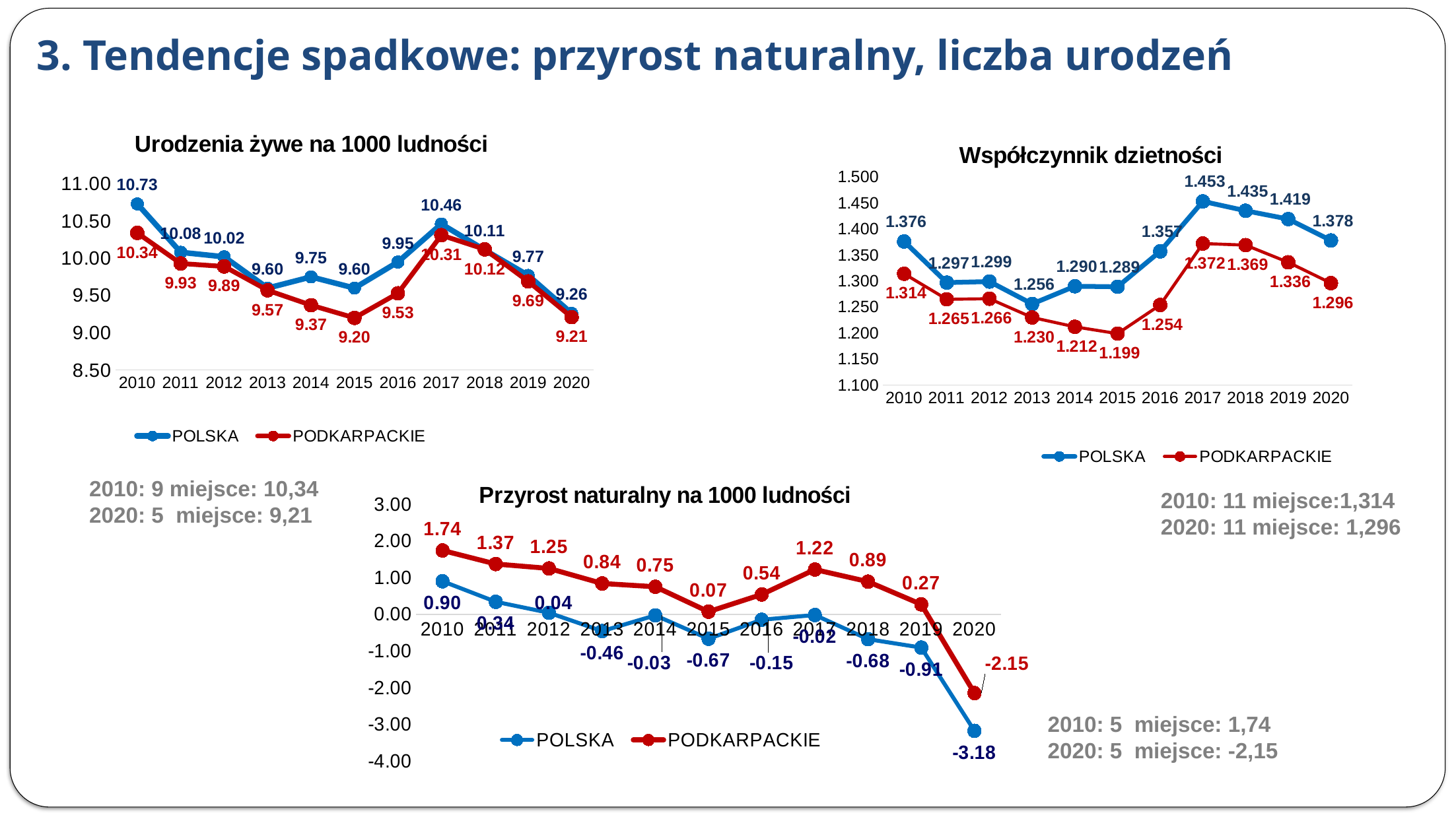
In the chart 'Urodzenia żywe na 1000 ludności', what is the value for POLSKA in 2010? 10.73 In the chart 'Urodzenia żywe na 1000 ludności', what is the value for PODKARPACKIE in 2015? 9.20 In the chart 'Współczynnik dzietności', which series has the higher value in 2020, POLSKA or PODKARPACKIE? POLSKA In the chart 'Urodzenia żywe na 1000 ludności', in which year is the PODKARPACKIE value lowest? 2015 In the chart 'Współczynnik dzietności', in which year is the PODKARPACKIE value lowest? 2015 What type of chart is 'Współczynnik dzietności'? Line chart In the chart 'Przyrost naturalny na 1000 ludności', in which year is the PODKARPACKIE value highest? 2010 How many years are shown on the x axis of the chart 'Przyrost naturalny na 1000 ludności'? 11 In the chart 'Współczynnik dzietności', what is the value for POLSKA in 2017? 1.453 In the chart 'Przyrost naturalny na 1000 ludności', what is the value for POLSKA in 2020? -3.18 In the chart 'Urodzenia żywe na 1000 ludności', what is the difference between the POLSKA and PODKARPACKIE values in 2020? 0.05 In the chart 'Przyrost naturalny na 1000 ludności', what is the difference between the PODKARPACKIE and POLSKA values in 2010? 0.84